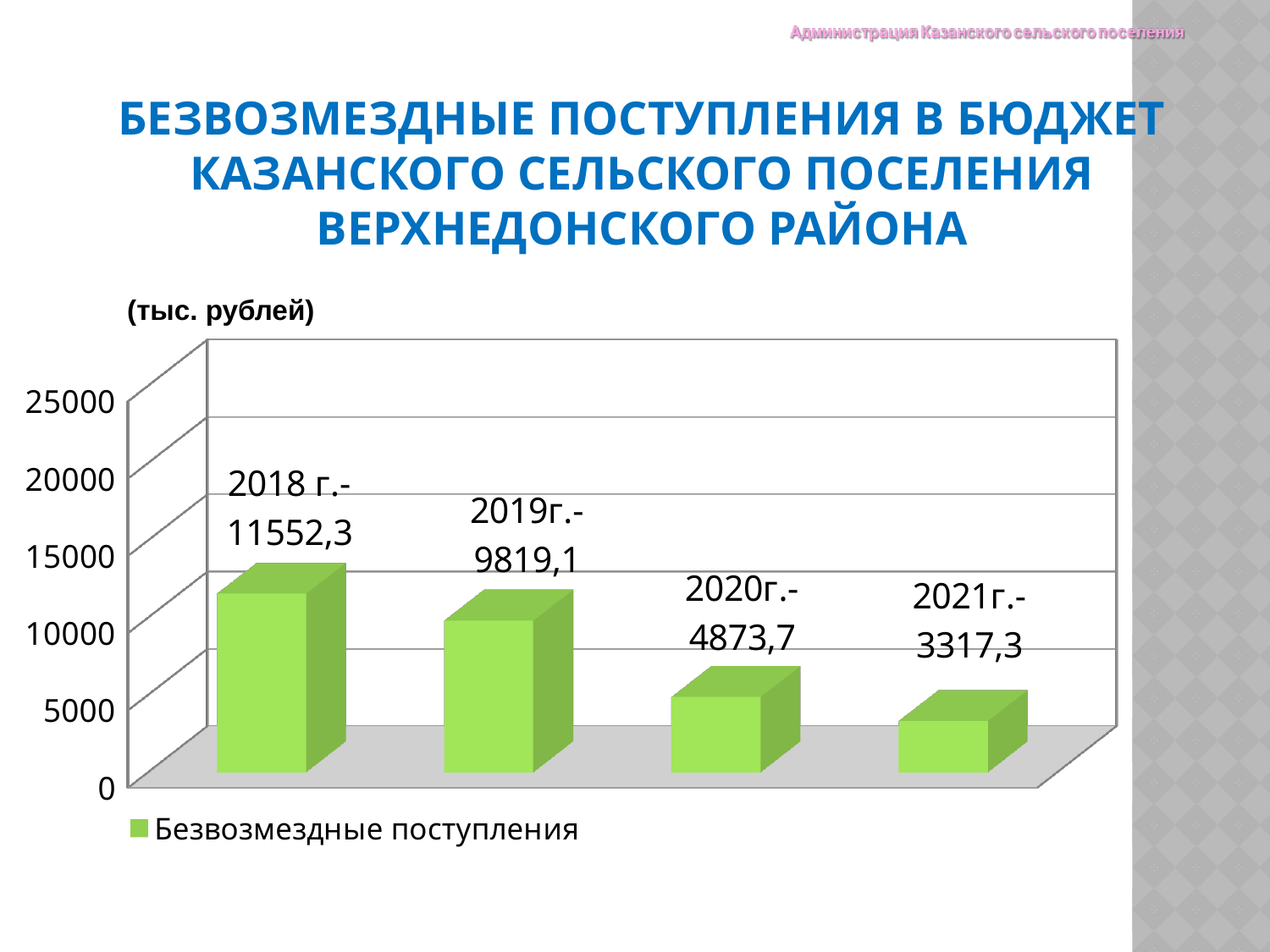
What is the value for 2020г.? 4873,7 What is the difference between the values for 2019г. and 2020г.? 4945,4 Which year has the highest value? 2018 г. What is the difference between the values for 2018 г. and 2019г.? 1733,2 How many years are shown in the chart? 4 What kind of chart is shown on the slide? bar chart Which year has the lowest value? 2021г. Which is larger, the value for 2020г. or the value for 2021г.? 2020г. Do the values rise or fall from 2018 г. to 2021г.? fall What is the value for 2019г.? 9819,1 What is the value for 2018 г.? 11552,3 What is the value for 2021г.? 3317,3